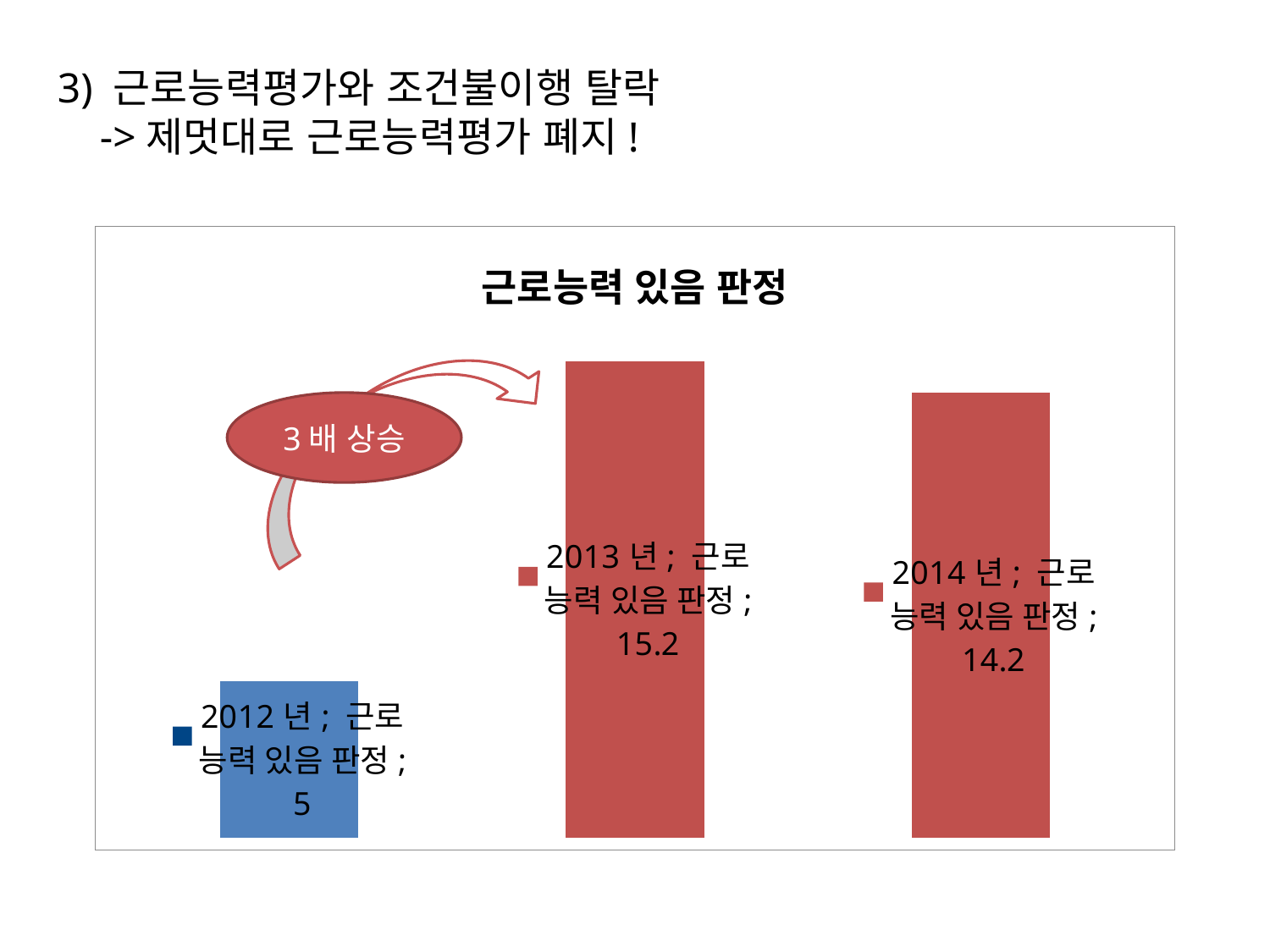
What is the difference between the values for 2013년 and 2012년? 10.2 Which is larger, the value for 2014년 or the value for 2012년? 2014년 What is the title of the chart? 근로능력 있음 판정 What is the value for 2013년 in the chart? 15.2 What is the difference between the values for 2013년 and 2014년? 1 What is the value for 2012년 in the chart? 5 What is the value for 2014년 in the chart? 14.2 Which year has the lowest value in the chart? 2012년 What kind of chart is shown on the slide? bar chart What colour is the bar for 2012년? blue Which year has the highest value in the chart? 2013년 How many bars are plotted in the chart? 3